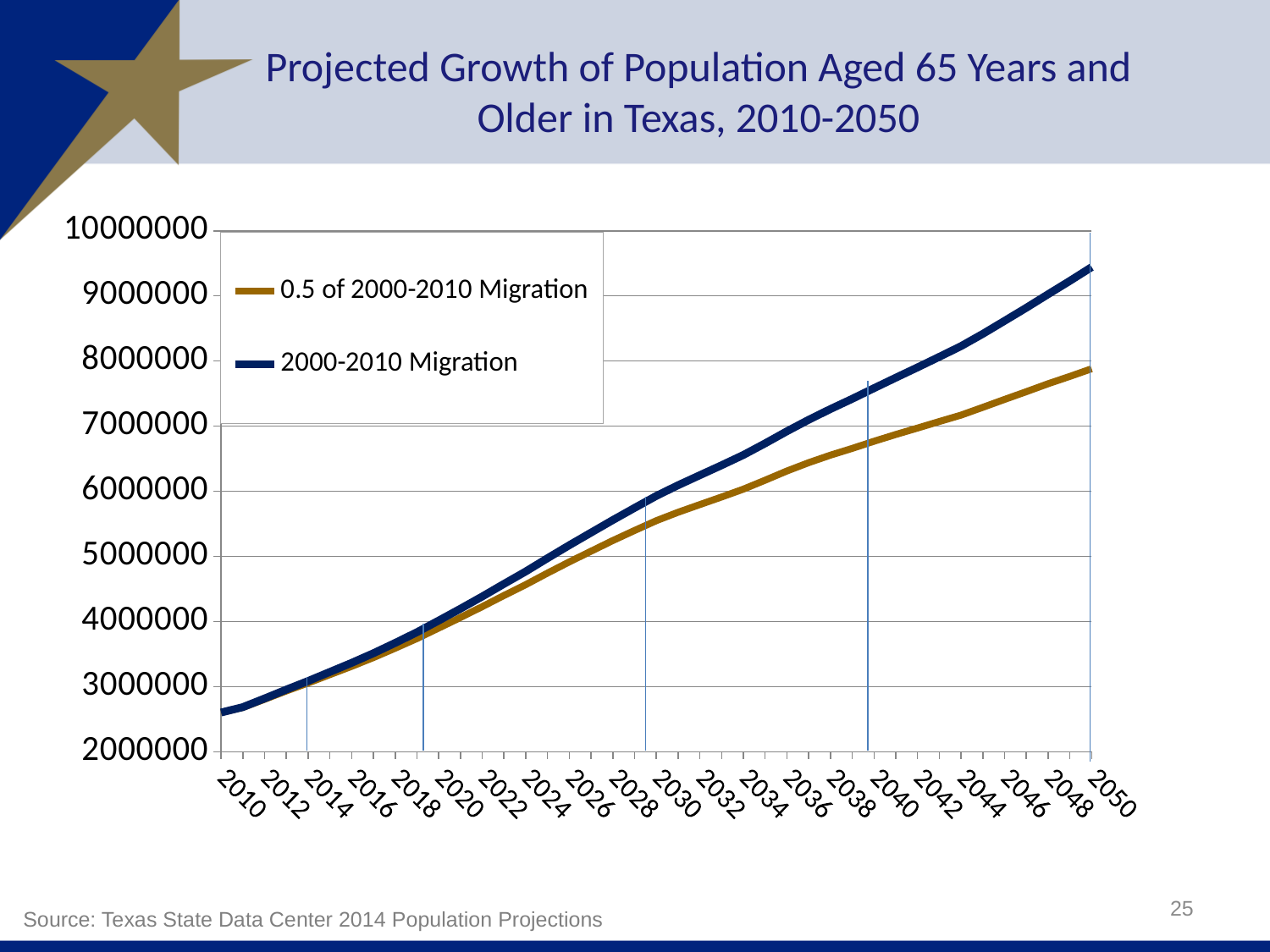
Is the value for the 2000-2010 Migration series in 2050 greater or less than 9000000? greater What is the title of the chart? Projected Growth of Population Aged 65 Years and Older in Texas, 2010-2050 In 2050, which series has the higher value: 2000-2010 Migration or 0.5 of 2000-2010 Migration? 2000-2010 Migration Do the values for the 2000-2010 Migration series rise or fall from 2010 to 2050? rise In which year does the 2000-2010 Migration series reach its highest value? 2050 Is the value for the 0.5 of 2000-2010 Migration series in 2040 greater or less than 7000000? less What kind of chart is shown on the slide? line chart Is the value for the 2000-2010 Migration series in 2010 greater or less than 3000000? less Which series is drawn in the dark blue line? 2000-2010 Migration How many series does the legend list? 2